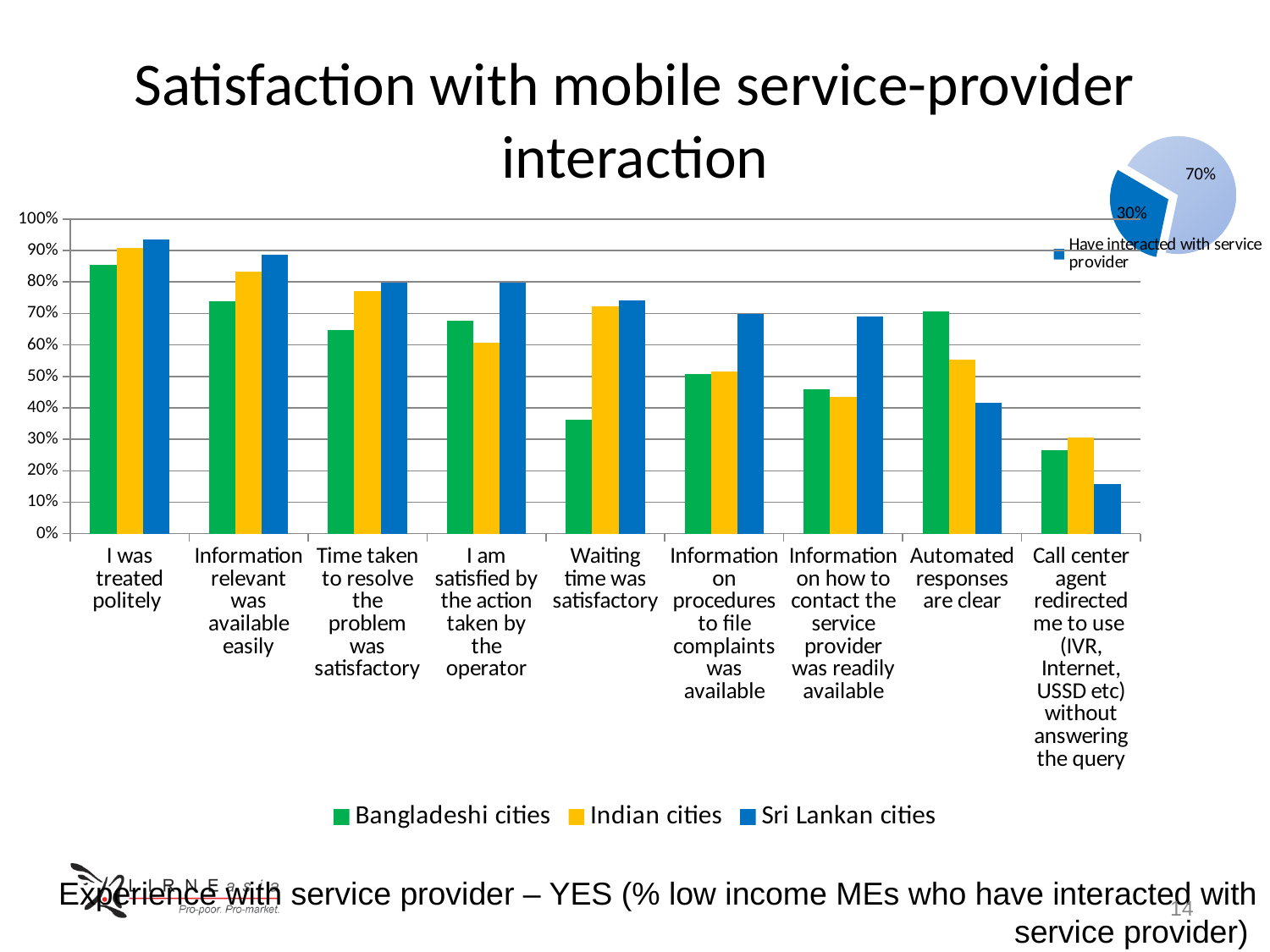
In the main bar chart, is the value for Sri Lankan cities for 'I was treated politely' greater or less than 90%? greater In the pie chart at the top right, what share does the larger slice represent? 70% In the main bar chart, which category has the lowest value for Sri Lankan cities? Call center agent redirected me to use (IVR, Internet, USSD etc) without answering the query In the main bar chart, is the value for Indian cities for 'Call center agent redirected me to use (IVR, Internet, USSD etc) without answering the query' greater or less than 40%? less In the main bar chart, for 'Automated responses are clear', which is larger: Bangladeshi cities or Sri Lankan cities? Bangladeshi cities In the main bar chart, is the value for Bangladeshi cities for 'Waiting time was satisfactory' greater or less than 40%? less What kind of chart is the main chart on the slide? bar chart In the main bar chart, how many categories are shown on the x axis? 9 In the main bar chart, which category has the highest value for Sri Lankan cities? I was treated politely In the main bar chart, how many series does the legend list? 3 In the main bar chart, for 'Waiting time was satisfactory', which is larger: Bangladeshi cities or Indian cities? Indian cities In the main bar chart, what are the three series listed in the legend? Bangladeshi cities, Indian cities, Sri Lankan cities